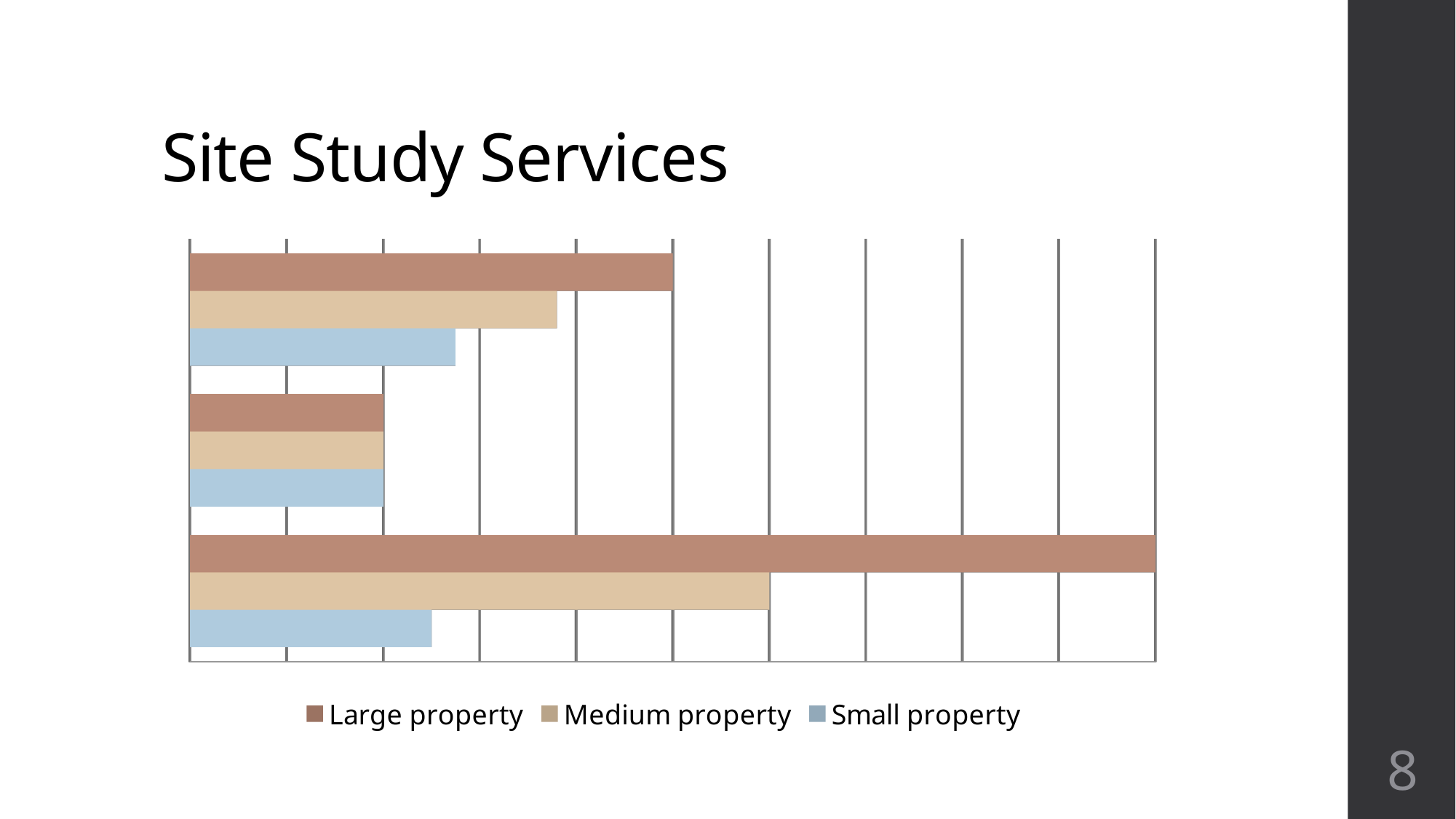
How many groups of bars (categories) are plotted in the chart? 3 Which series is listed first in the legend? Large property Which series has the single longest bar in the chart? Large property Which series is shown in light blue? Small property Are the bars in the chart drawn horizontally or vertically? horizontally What kind of chart is shown on the slide? bar chart How many series does the legend list? 3 Is the longest bar in the chart from the Large property series or the Small property series? Large property